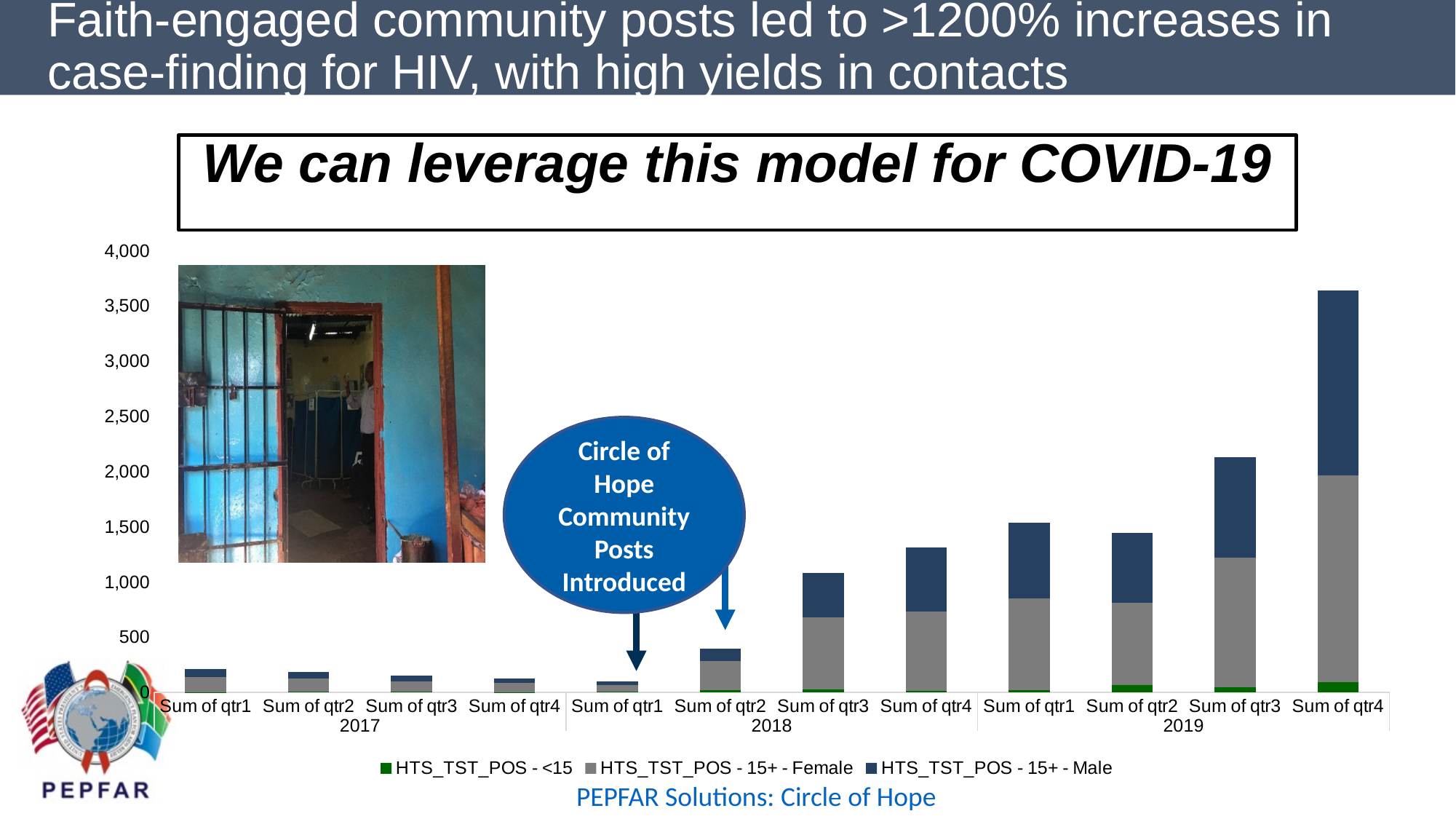
Which series is shown in green in the chart legend? HTS_TST_POS - <15 Which bar is taller: Sum of qtr3 2019 or Sum of qtr1 2019? Sum of qtr3 2019 Is the total for Sum of qtr4 2019 greater or less than 3,000? greater Which quarter has the shortest bar in the chart? Sum of qtr1 2018 How many quarterly bars are plotted in the chart? 12 Is the total for Sum of qtr3 2019 greater or less than 1,500? greater Do the bar totals rise or fall across the four quarters of 2018? rise What kind of chart is shown on the slide? Stacked bar chart How many series does the chart legend list? 3 Which quarter has the tallest bar in the chart? Sum of qtr4 2019 Is the total for Sum of qtr1 2017 greater or less than 500? less